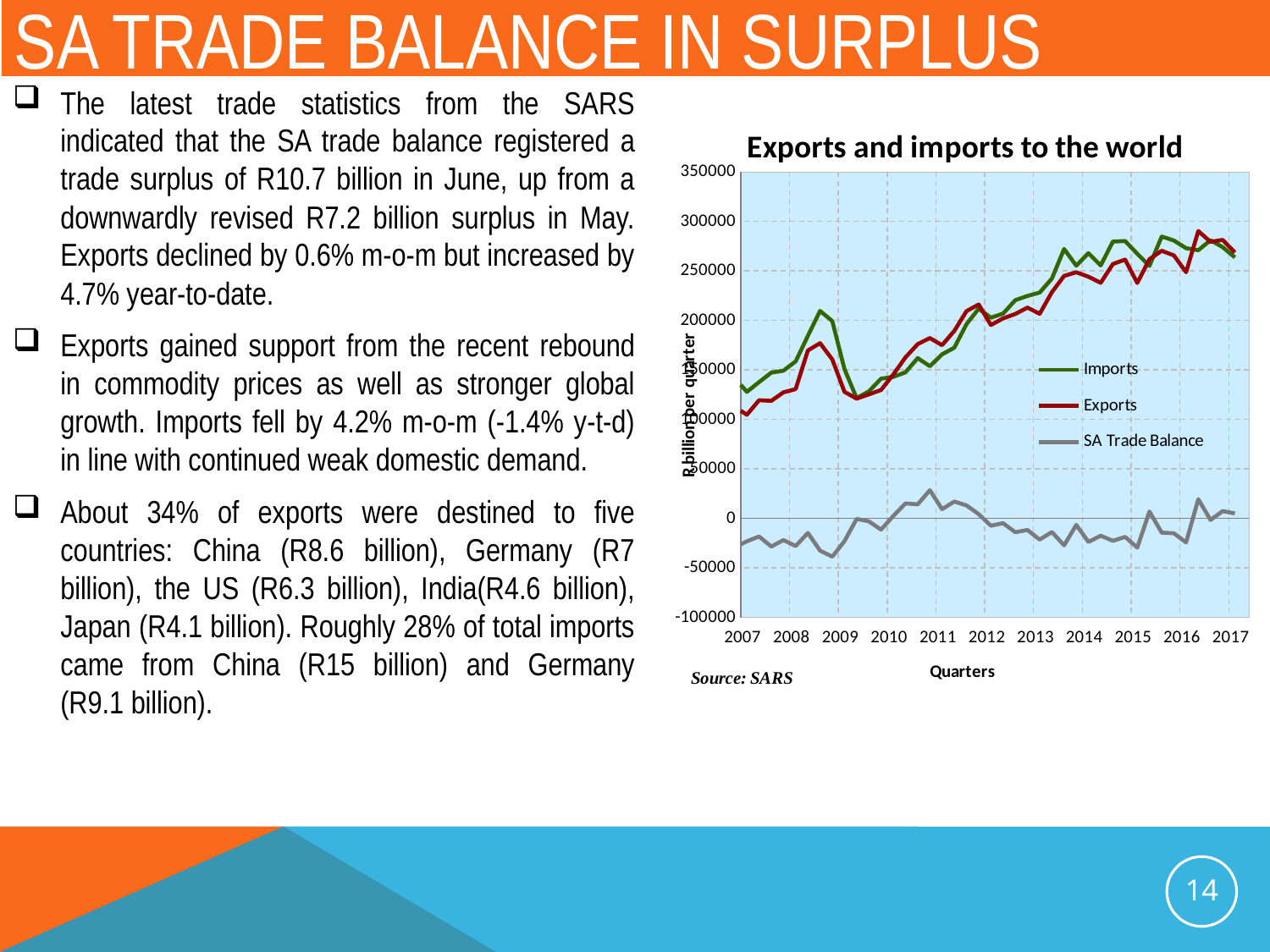
Which series has the lowest values throughout the chart? SA Trade Balance How many year labels appear on the x axis of the chart? 11 How many series does the legend of the 'Exports and imports to the world' chart list? 3 What kind of chart is 'Exports and imports to the world'? line chart Is the value of Exports at 2016 greater or less than 200000? greater Is the SA Trade Balance at 2009 greater or less than 0? less Is the value of Imports at 2017 greater or less than 250000? greater What is the label on the x axis of the chart? Quarters What are the three series shown in the legend of the chart? Imports, Exports, SA Trade Balance At 2008, which is higher, Imports or Exports? Imports Do Exports generally rise or fall from 2009 to 2016? rise